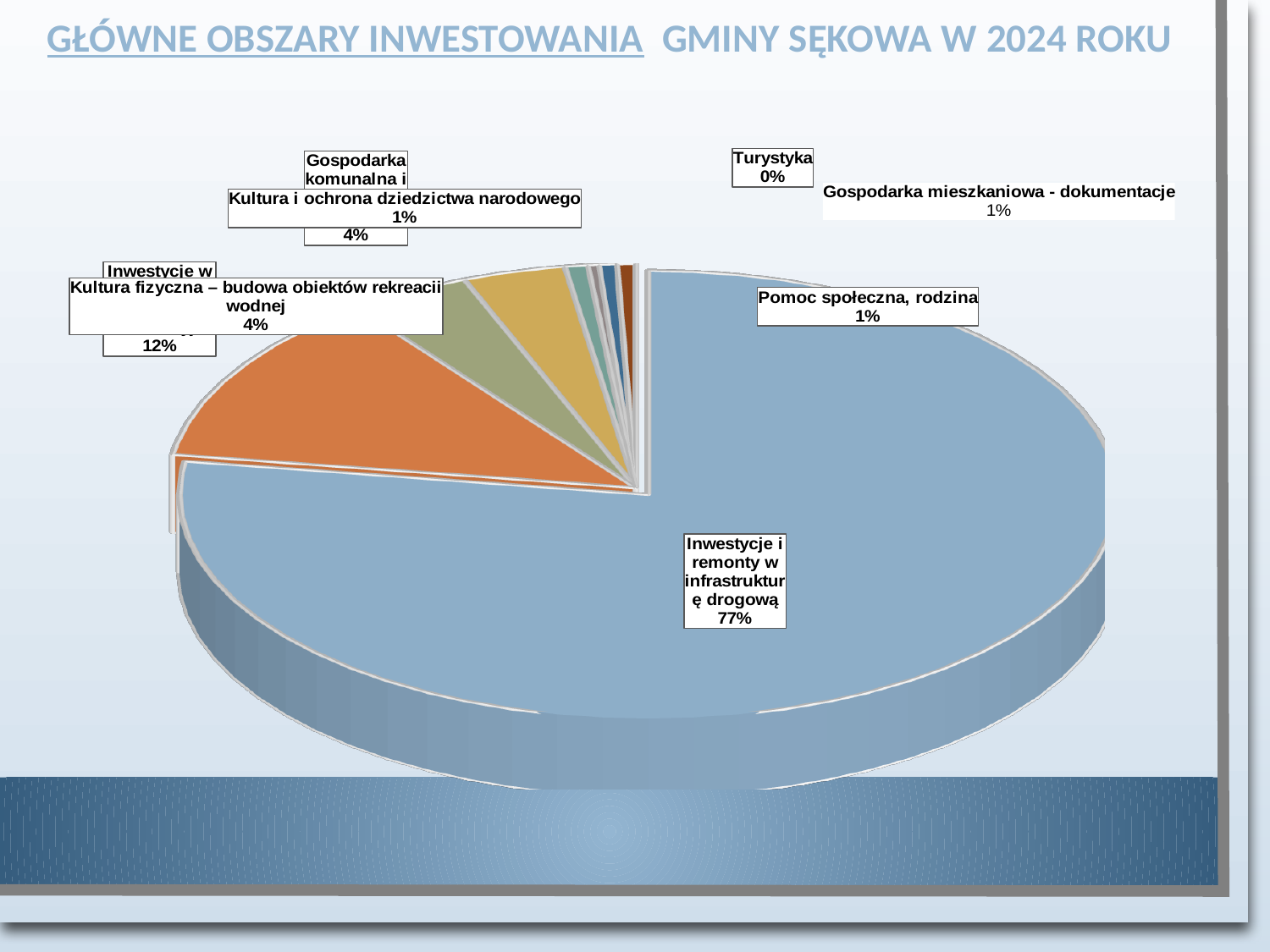
What percentage is shown for "Gospodarka mieszkaniowa - dokumentacje"? 1% What share of the pie does "Inwestycje i remonty w infrastrukturę drogową" represent? 77% What is the title of the slide? GŁÓWNE OBSZARY INWESTOWANIA GMINY SĘKOWA W 2024 ROKU What percentage is shown for "Kultura fizyczna – budowa obiektów rekreacji wodnej"? 4% Which has a larger share: "Kultura fizyczna – budowa obiektów rekreacji wodnej" or "Pomoc społeczna, rodzina"? Kultura fizyczna – budowa obiektów rekreacji wodnej What type of chart is shown on the slide? Pie chart Which category has the smallest share of the pie? Turystyka How many percentage points larger is the share for "Inwestycje i remonty w infrastrukturę drogową" than for "Kultura fizyczna – budowa obiektów rekreacji wodnej"? 73 percentage points Which category has the largest share of the pie? Inwestycje i remonty w infrastrukturę drogową What percentage is shown for "Kultura i ochrona dziedzictwa narodowego"? 1% What percentage is shown for "Turystyka"? 0% What percentage is shown for "Pomoc społeczna, rodzina"? 1%